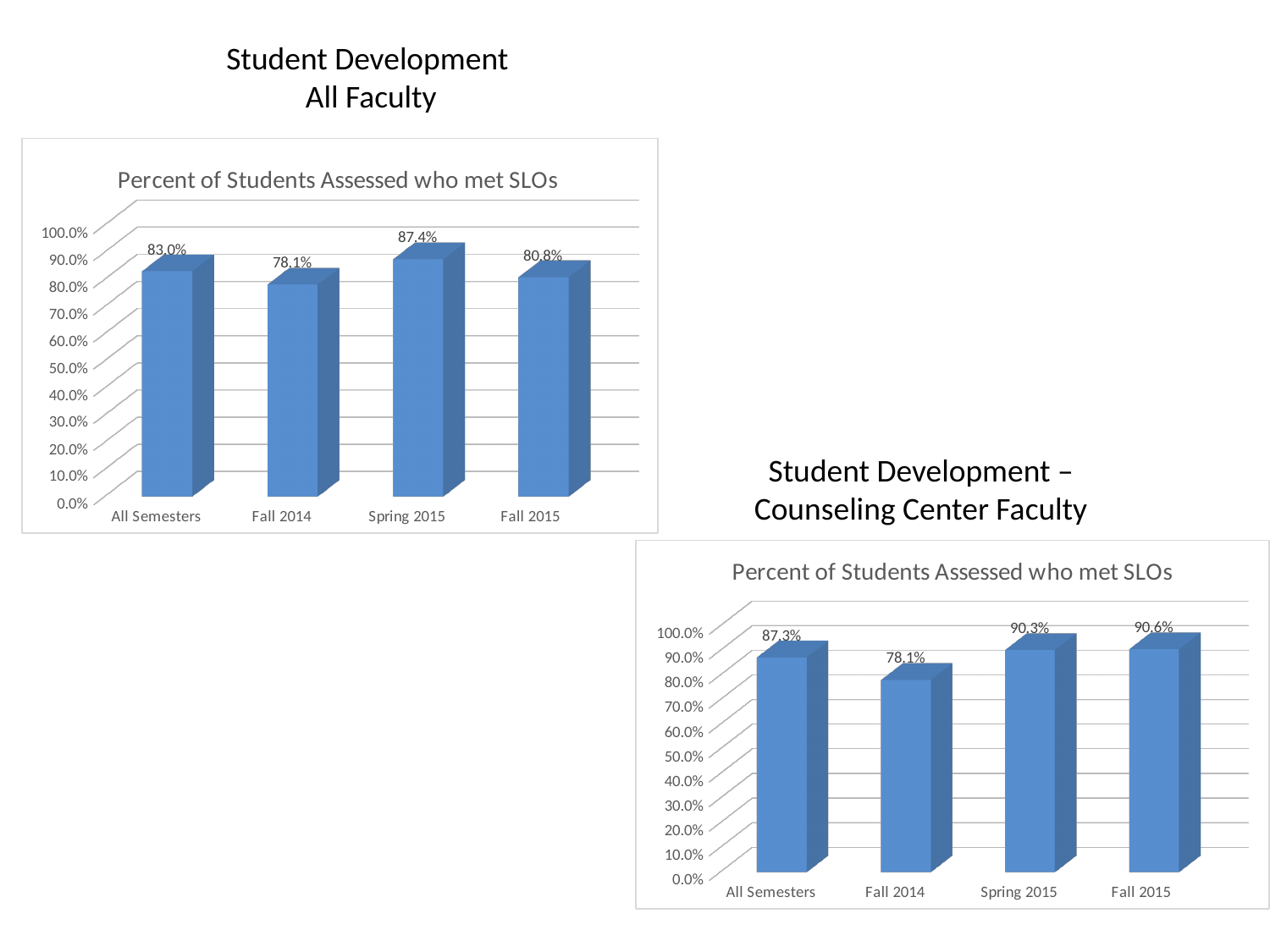
Which is larger: the Fall 2015 value in the All Faculty chart or the Fall 2015 value in the Counseling Center Faculty chart? Counseling Center Faculty In the Student Development – Counseling Center Faculty chart, what is the value for All Semesters? 87.3% In the Student Development All Faculty chart, which category has the highest value? Spring 2015 In the Student Development All Faculty chart, what is the value for Fall 2014? 78.1% In the Student Development All Faculty chart, what is the value for Spring 2015? 87.4% In the Student Development All Faculty chart, which category has the lowest value? Fall 2014 What kind of chart is the Student Development – Counseling Center Faculty chart? Bar chart In the Student Development All Faculty chart, what is the difference between the All Semesters value and the Fall 2015 value? 2.2% In the Student Development – Counseling Center Faculty chart, which category has the lowest value? Fall 2014 In the Student Development – Counseling Center Faculty chart, what is the value for Fall 2015? 90.6% In the Student Development – Counseling Center Faculty chart, what is the difference between the Spring 2015 value and the Fall 2014 value? 12.2% How many categories are shown on the x axis of the Student Development All Faculty chart? 4